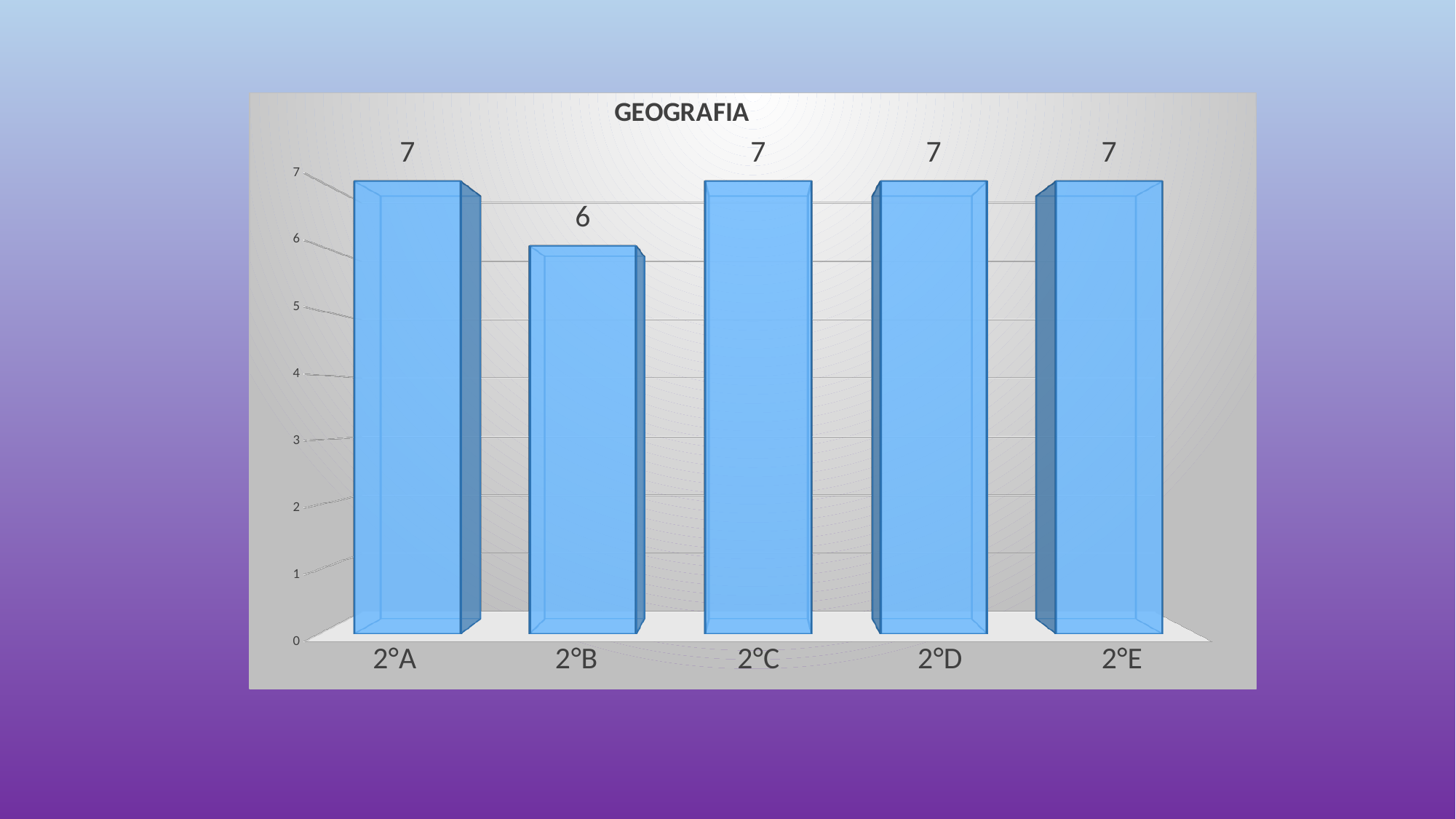
What is the value for 2°C? 7 What is the value for 2°B? 6 Which category has the lowest value? 2°B What is the title of the chart? GEOGRAFIA What is the value for 2°A? 7 Is the value for 2°B greater or less than 4? greater Which is larger, the value for 2°B or the value for 2°D? 2°D What is the value for 2°E? 7 What is the difference between the values for 2°A and 2°B? 1 How many categories are shown on the x axis? 5 What is the highest value shown on the vertical axis? 7 What kind of chart is shown? bar chart